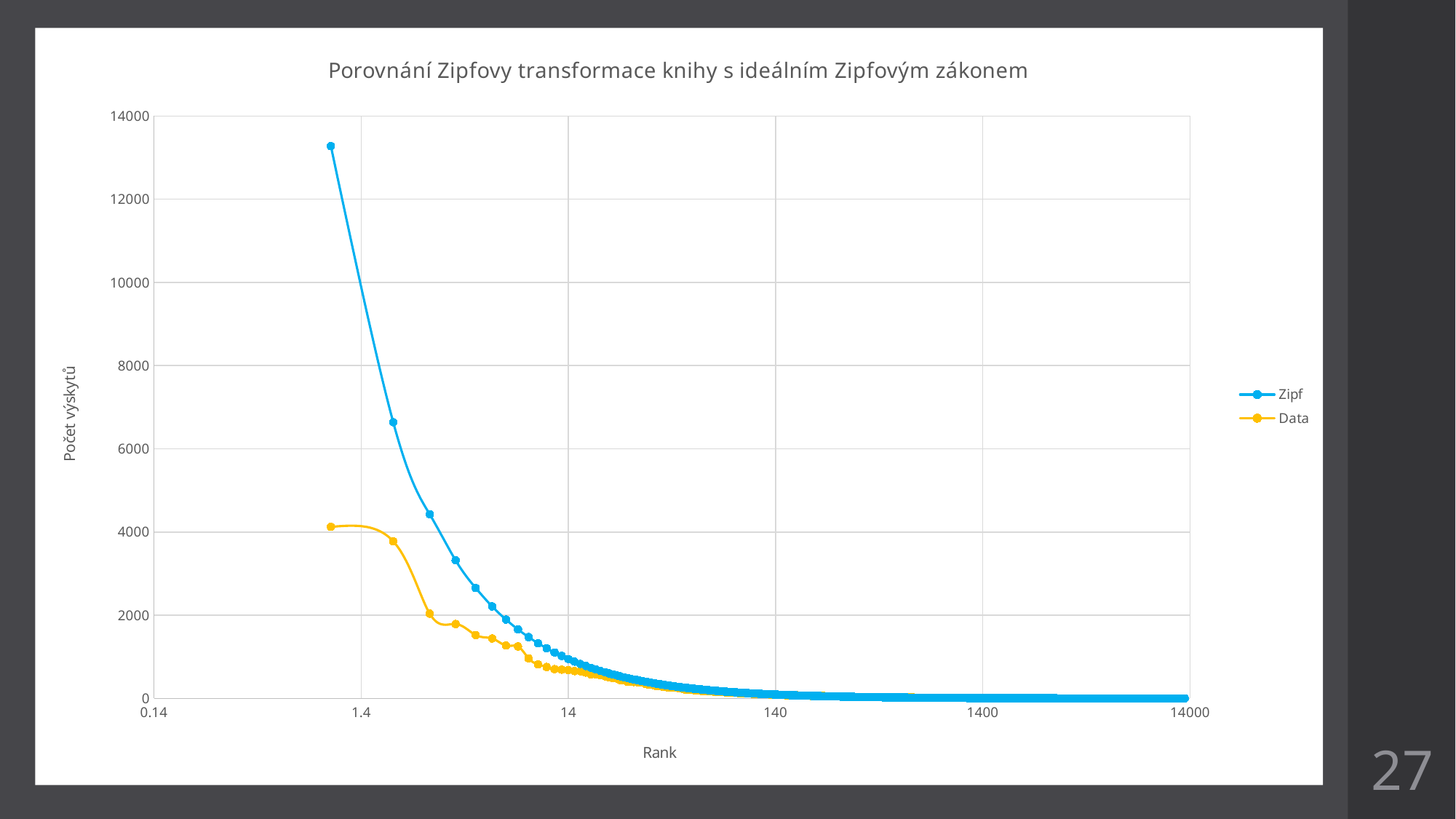
What is the label of the x axis? Rank Which series reaches the highest value on the chart? Zipf Do the values of the Zipf series rise or fall as rank increases along the x axis? fall How many series does the legend list? 2 What is the highest tick value shown on the y axis? 14000 What is the title of the chart? Porovnání Zipfovy transformace knihy s ideálním Zipfovým zákonem At the lowest rank, which series has the larger value, Zipf or Data? Zipf Do the values of the Data series rise or fall as rank increases along the x axis? fall What kind of chart is shown on the slide? line chart Is the highest value of the Zipf series greater or less than 12000? greater Is the first value of the Data series greater or less than 2000? greater Is the highest value of the Data series greater or less than 6000? less